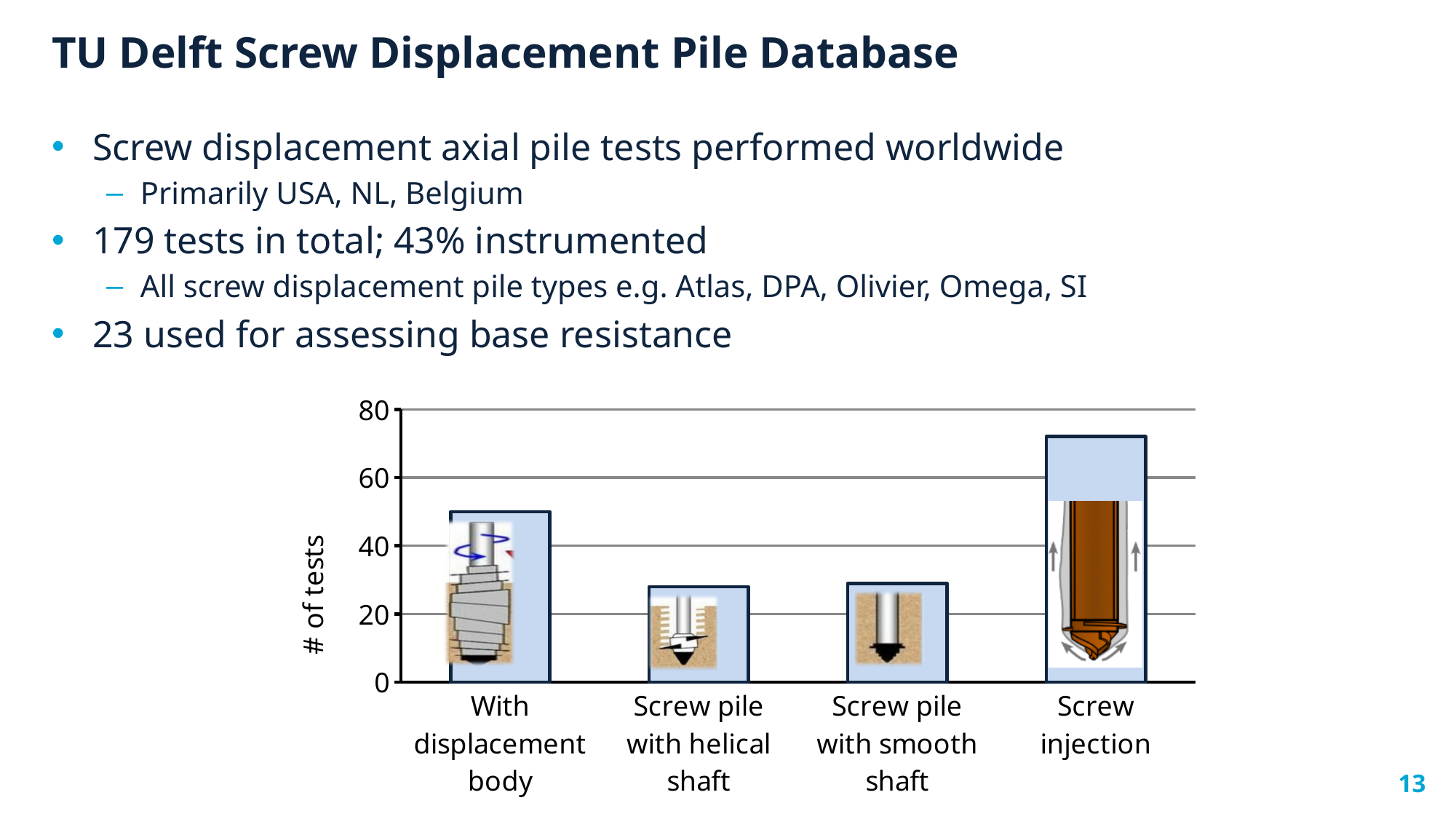
Is the value for With displacement body greater or less than 60? less How many categories are shown on the x axis of the chart? 4 Is the value for Screw pile with helical shaft greater or less than 40? less Which has more tests: With displacement body or Screw pile with helical shaft? With displacement body Is the value for Screw injection greater or less than 60? greater What kind of chart is shown on the slide? bar chart Which category has the highest number of tests? Screw injection Which has more tests: Screw injection or Screw pile with smooth shaft? Screw injection What is the label of the y axis of the chart? # of tests